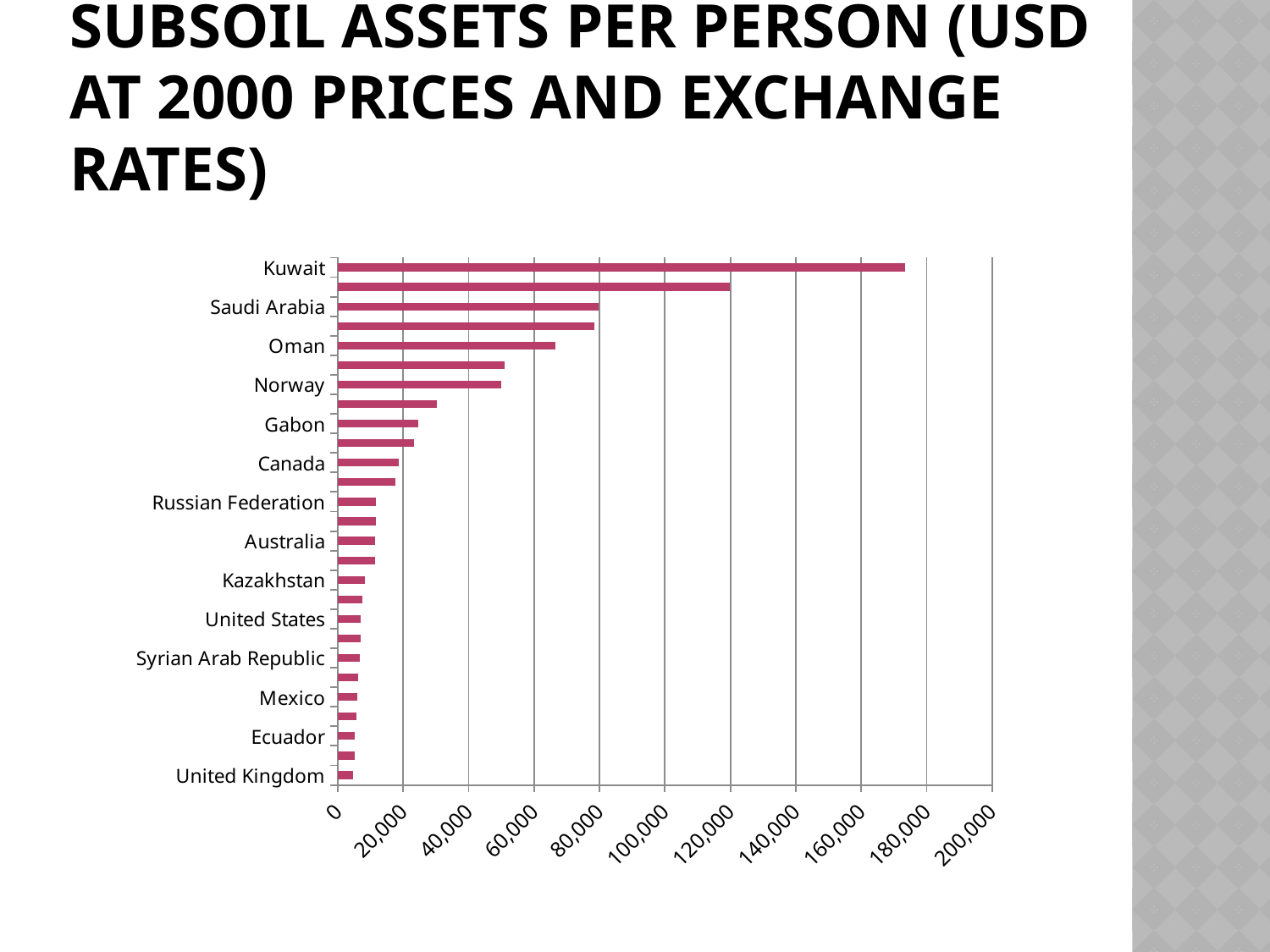
Which has a larger value, Oman or Norway? Oman Is the value for Oman greater or less than 60,000? greater Do the bar values increase or decrease going from the top of the chart to the bottom? decrease Is the value for Kuwait greater or less than 160,000? greater Is the value for Norway greater or less than 60,000? less Which country has the highest subsoil assets per person? Kuwait What is the title of the slide? Subsoil assets per person (USD at 2000 prices and exchange rates) Which labelled country has the lowest subsoil assets per person? United Kingdom What kind of chart is shown on the slide? bar chart Which has a larger value, Kuwait or Saudi Arabia? Kuwait